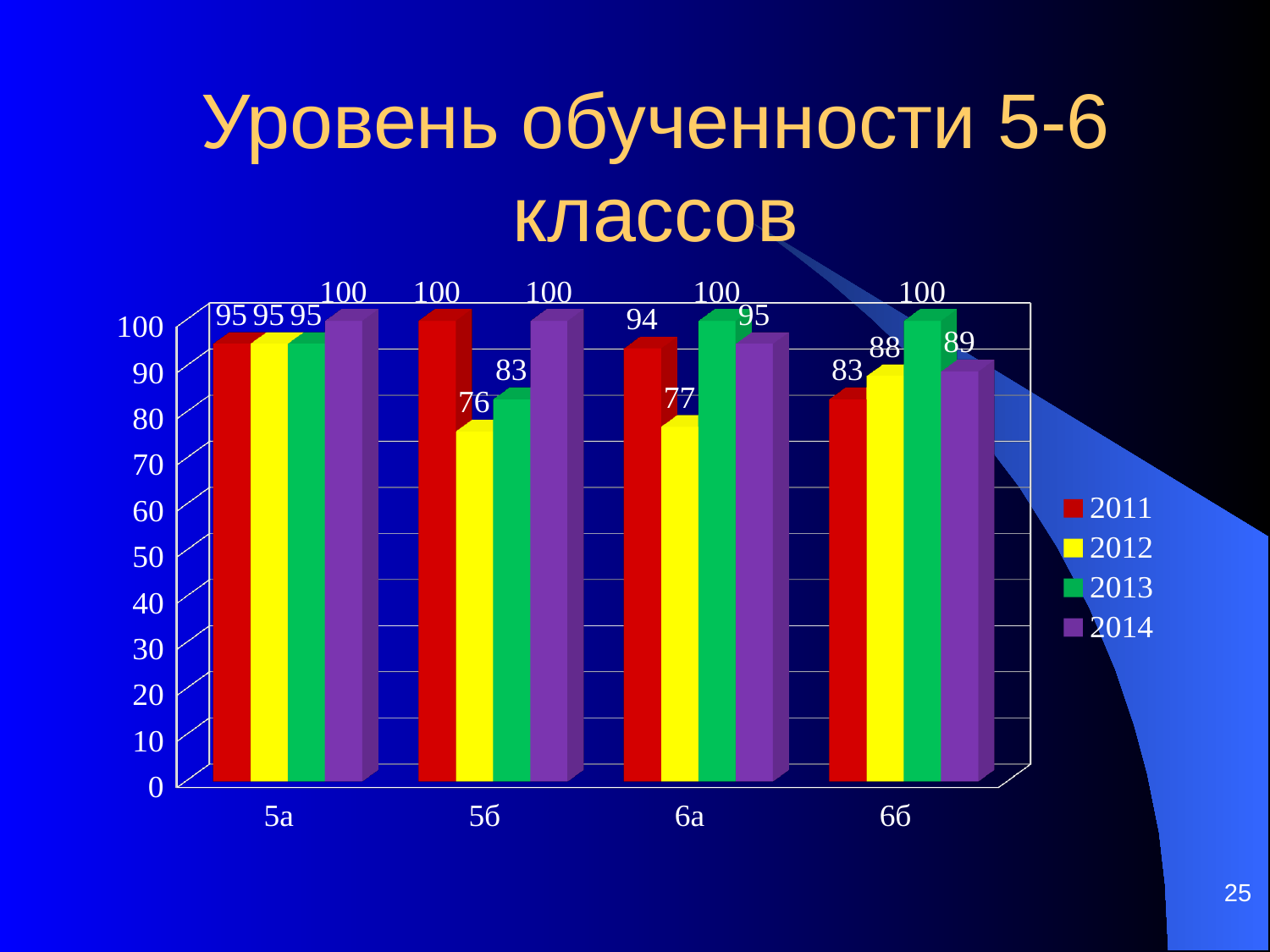
What is the value for 6а in the 2013 series? 100 How many series does the legend list? 4 Which category has the lowest value in the 2012 series? 5б How many categories are shown on the x axis? 4 Which is larger for 6б: the 2012 value or the 2014 value? 2014 What kind of chart is shown on the slide? bar chart What is the value for 5б in the 2012 series? 76 What is the difference between the 2011 and 2012 values for 5б? 24 What is the value for 6б in the 2011 series? 83 What is the title of the chart on the slide? Уровень обученности 5-6 классов Which category has the lowest value in the 2011 series? 6б What is the value for 5а in the 2014 series? 100